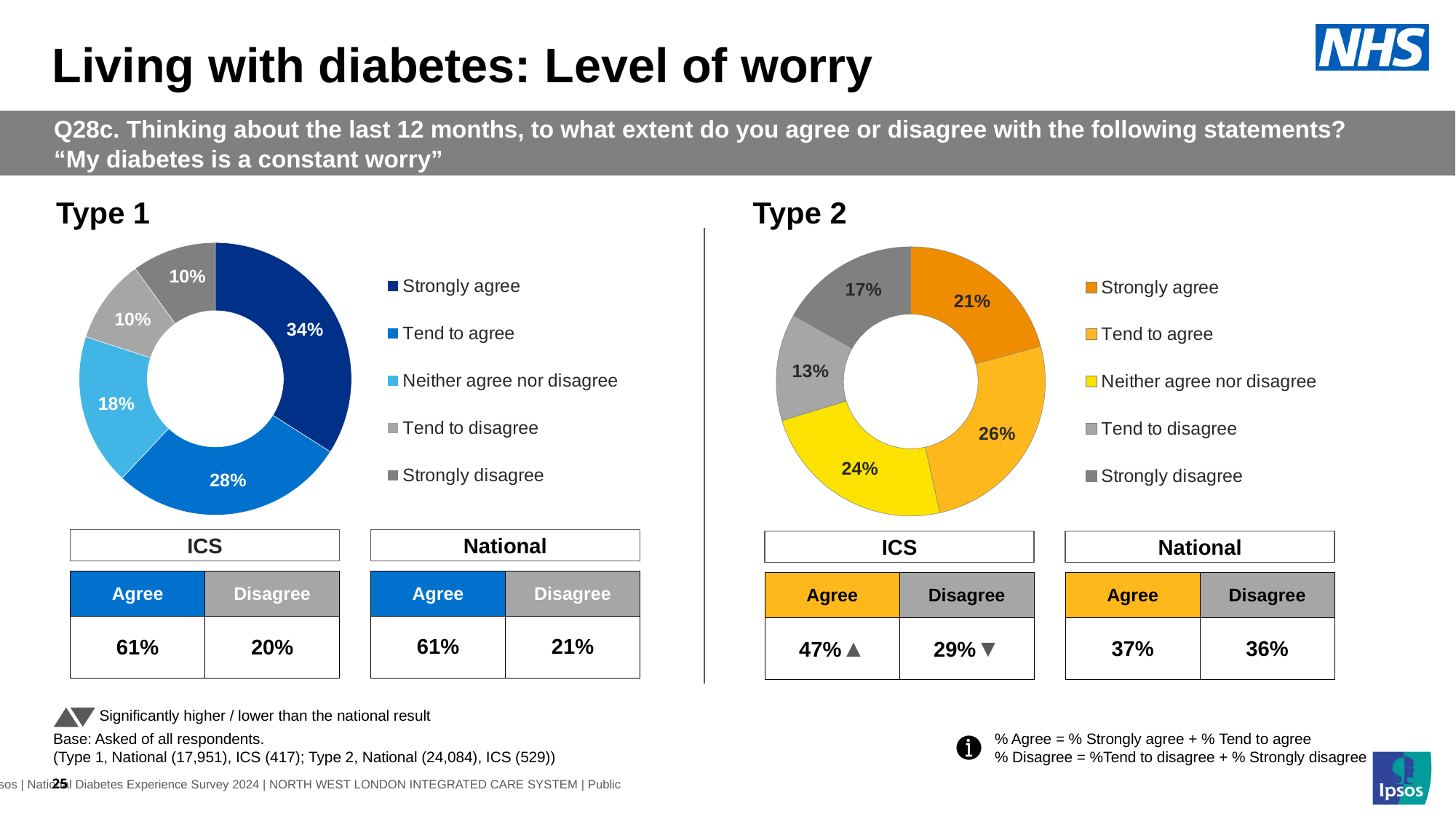
In the Type 2 chart, what percentage of respondents neither agree nor disagree? 24% In the Type 2 chart, what is the difference between the Strongly disagree and Tend to disagree shares? 4% In the Type 1 chart, what percentage of respondents tend to disagree? 10% In the Type 2 chart, what colour is the Neither agree nor disagree slice? Yellow In the Type 1 chart, what percentage of respondents strongly agree? 34% In the Type 2 chart, which category has the smallest share? Tend to disagree How many categories does the Type 2 chart show? 5 In the Type 1 chart, which category has the largest share? Strongly agree Which is larger: the Strongly agree share in the Type 1 chart or the Strongly agree share in the Type 2 chart? Type 1 In the Type 1 chart, what is the difference between the Strongly agree and Tend to agree shares? 6% In the Type 2 chart, which category has the largest share? Tend to agree What kind of chart is used for Type 1? Donut (pie) chart